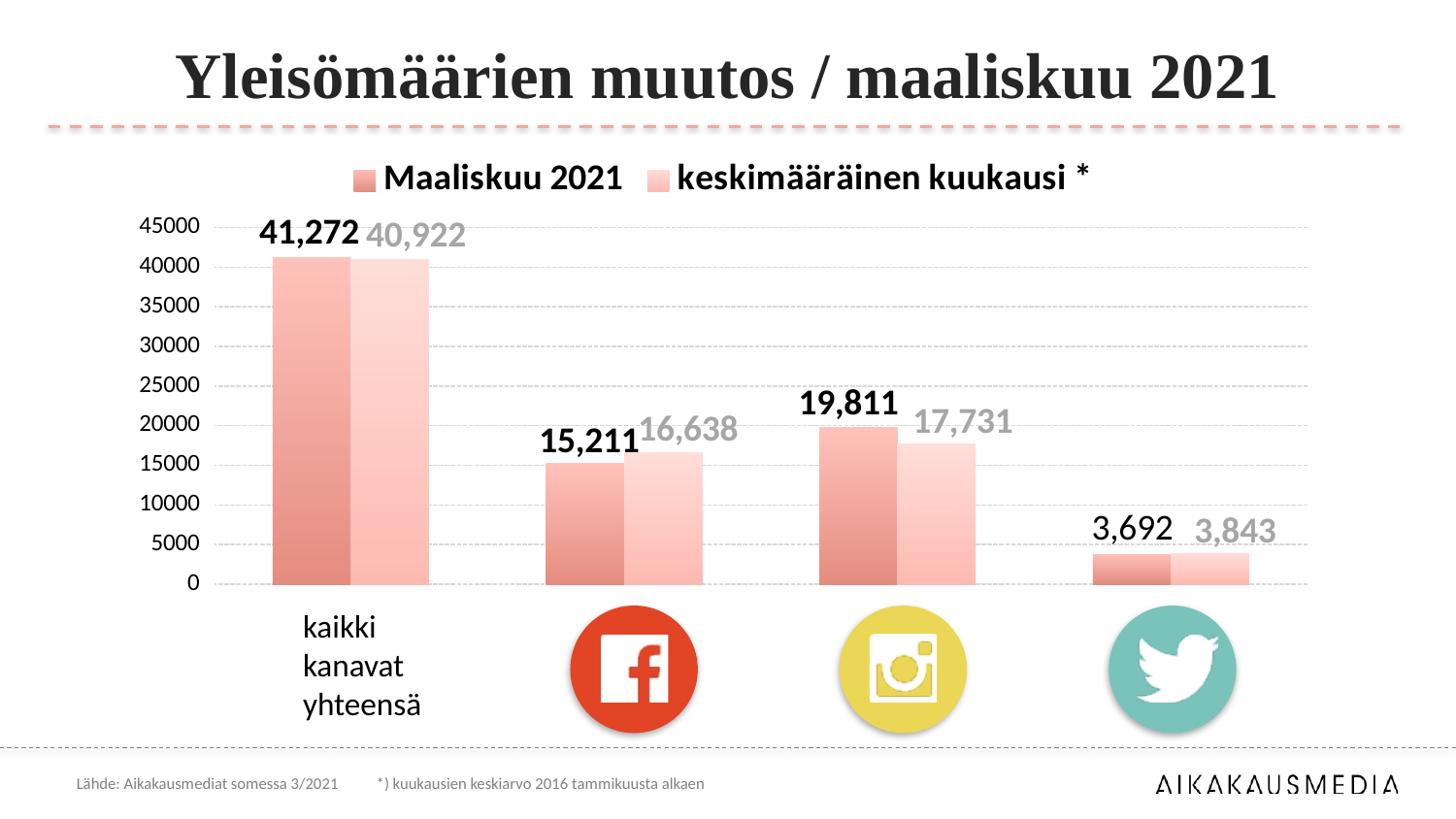
What kind of chart is shown on the slide? bar chart For the Facebook category, which is larger: the Maaliskuu 2021 value or the keskimääräinen kuukausi value? keskimääräinen kuukausi How many series does the legend list? 2 How many categories are shown on the x axis? 4 Among the individual channels (Facebook, Instagram, Twitter), which has the highest Maaliskuu 2021 value? Instagram What is the title of the slide? Yleisömäärien muutos / maaliskuu 2021 What is the keskimääräinen kuukausi value for the Twitter category? 3,843 What is the Maaliskuu 2021 value for kaikki kanavat yhteensä? 41,272 What is the Maaliskuu 2021 value for the Instagram category? 19,811 What is the difference between the Maaliskuu 2021 and keskimääräinen kuukausi values for the Instagram category? 2,080 What is the keskimääräinen kuukausi value for the Facebook category? 16,638 Which category has the lowest Maaliskuu 2021 value? Twitter